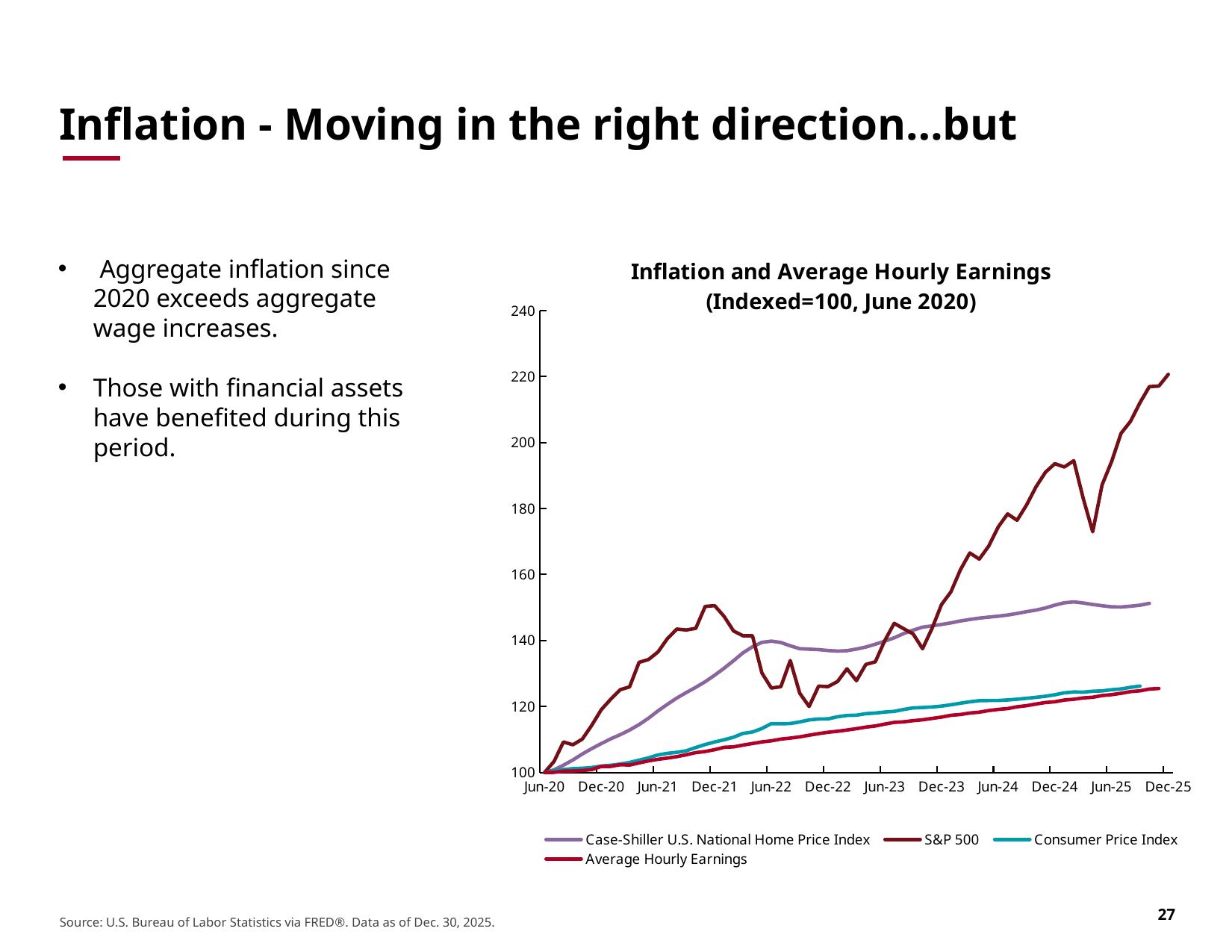
At Jun-22, which is higher: the Case-Shiller U.S. National Home Price Index or the S&P 500? Case-Shiller U.S. National Home Price Index What kind of chart is shown on the slide? Line chart What is the title of the chart? Inflation and Average Hourly Earnings (Indexed=100, June 2020) Which series has the lowest value at Dec-25? Average Hourly Earnings How many series does the chart's legend list? 4 Is the value for the Case-Shiller U.S. National Home Price Index at Dec-25 greater or less than 140? greater Is the value for the Consumer Price Index at Dec-25 greater or less than 140? less At Dec-21, which is higher: the S&P 500 or the Case-Shiller U.S. National Home Price Index? S&P 500 How many date labels are shown on the x axis? 12 Does the Average Hourly Earnings series rise or fall from Jun-20 to Dec-25? Rise Which series has the highest value at Dec-25? S&P 500 Is the value for the S&P 500 at Dec-25 greater or less than 200? greater